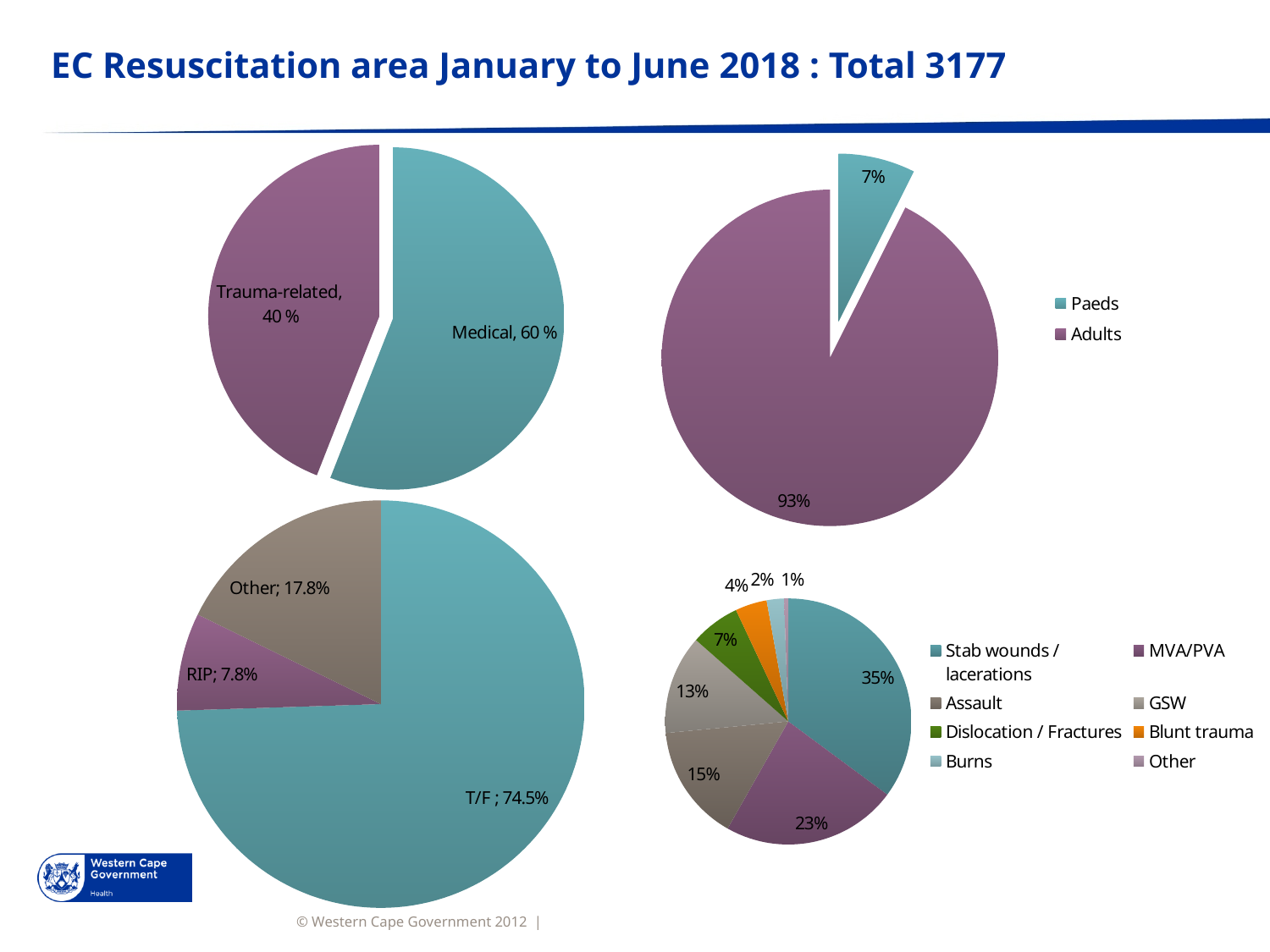
In the top-left pie chart, what share is labelled for Trauma-related? 40 % In the top-left pie chart, what share is labelled for Medical? 60 % In the bottom-right pie chart, which category has the largest slice? Stab wounds / lacerations In the top-right pie chart, what percentage is shown for Paeds? 7% In the bottom-left pie chart, what percentage is labelled for T/F? 74.5% In the bottom-left pie chart, what is the difference between the Other share and the RIP share? 10 percentage points In the bottom-right pie chart, what percentage is shown for MVA/PVA? 23% In the bottom-left pie chart, how many slices are there? 3 In the bottom-left pie chart, what percentage is labelled for RIP? 7.8% In the top-right pie chart, what percentage is shown for Adults? 93% In the top-right pie chart, which category has the larger slice, Paeds or Adults? Adults How many categories does the legend of the bottom-right pie chart list? 8